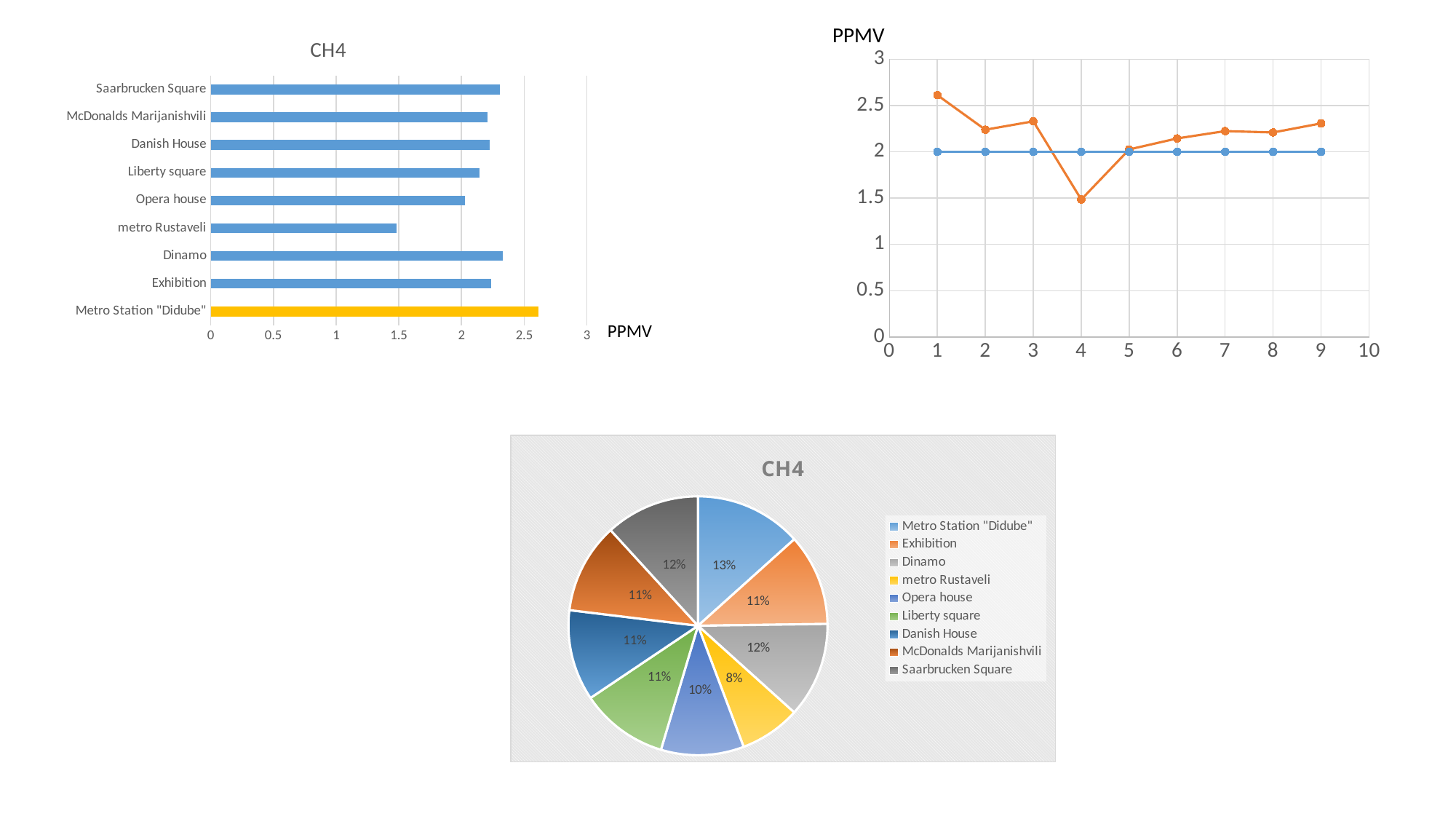
In the top-left bar chart titled CH4, is the value for Metro Station "Didube" greater or less than 2.5? greater In the top-left bar chart titled CH4, how many locations are plotted? 9 In the top-right line chart titled PPMV, is the orange line's value at x = 4 greater or less than 2? less In the bottom pie chart titled CH4, what share does Metro Station "Didube" have? 13% What kind of chart is the bottom chart titled CH4? pie chart In the top-left bar chart titled CH4, is the value for metro Rustaveli greater or less than 2? less In the top-right line chart titled PPMV, how many data points does the orange line have? 9 In the top-left bar chart titled CH4, which location has the highest value? Metro Station "Didube" In the top-left bar chart titled CH4, which location has the lowest value? metro Rustaveli In the bottom pie chart titled CH4, which location has the smallest slice? metro Rustaveli In the top-left bar chart titled CH4, which bar is coloured differently from the others? Metro Station "Didube" In the top-right line chart titled PPMV, at which x value does the orange line reach its lowest point? 4